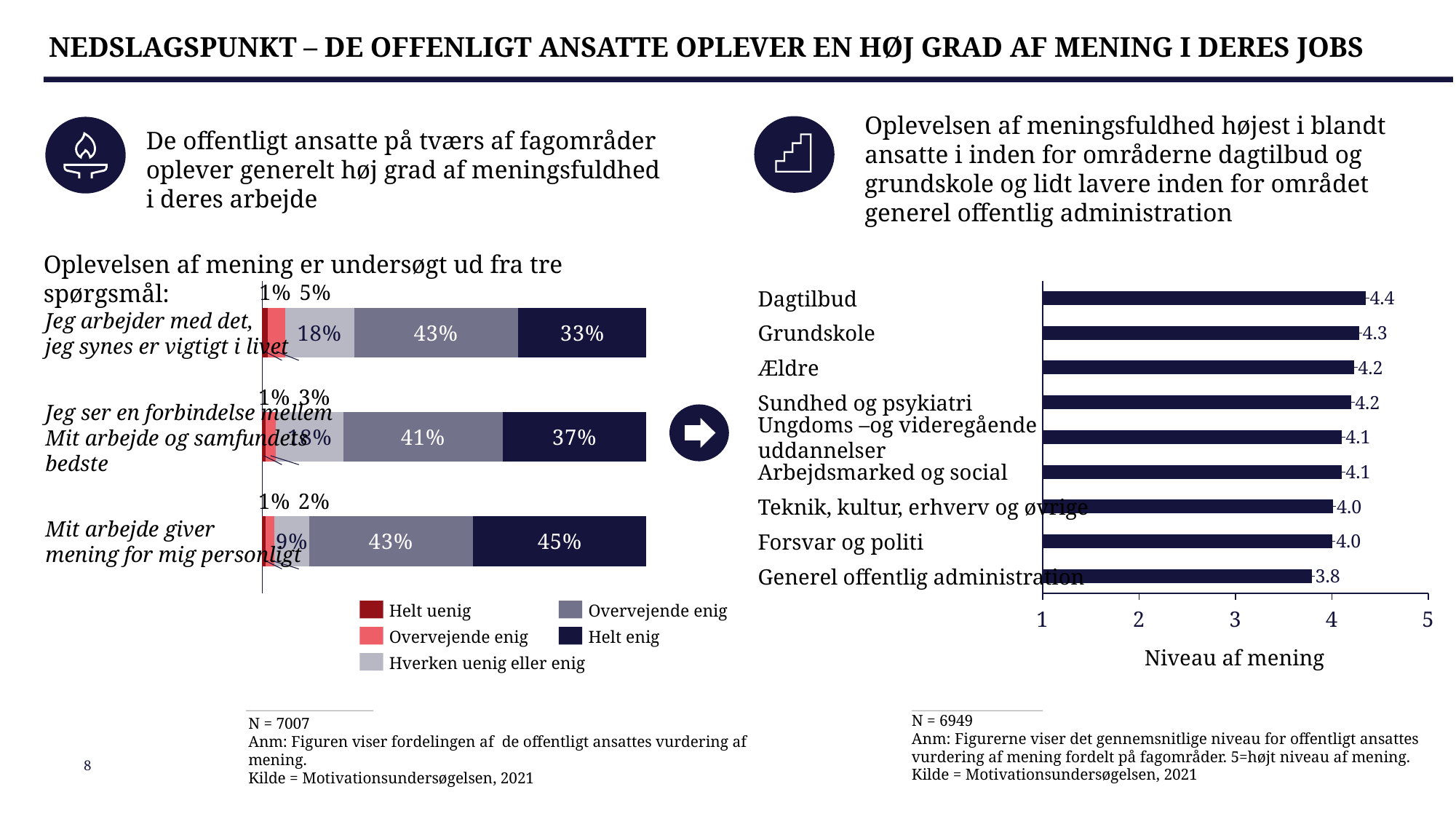
What kind of chart is the right chart (Niveau af mening)? Bar chart In the left stacked bar chart, what percentage answered 'Hverken uenig eller enig' to 'Mit arbejde giver mening for mig personligt'? 9% In the right chart (Niveau af mening), what is the value for Dagtilbud? 4.4 In the right chart (Niveau af mening), what is the difference between the values for Dagtilbud and Generel offentlig administration? 0.6 In the right chart (Niveau af mening), how many categories are shown? 9 In the right chart (Niveau af mening), what is the value for Generel offentlig administration? 3.8 In the left stacked bar chart, how many series does the legend list? 5 In the left stacked bar chart, what percentage answered 'Helt enig' to 'Jeg arbejder med det, jeg synes er vigtigt i livet'? 33% In the left stacked bar chart, what percentage answered 'Helt enig' to 'Mit arbejde giver mening for mig personligt'? 45% In the right chart (Niveau af mening), which category has the highest value? Dagtilbud In the right chart (Niveau af mening), which category has the lowest value? Generel offentlig administration In the right chart (Niveau af mening), which is larger: the value for Grundskole or the value for Forsvar og politi? Grundskole